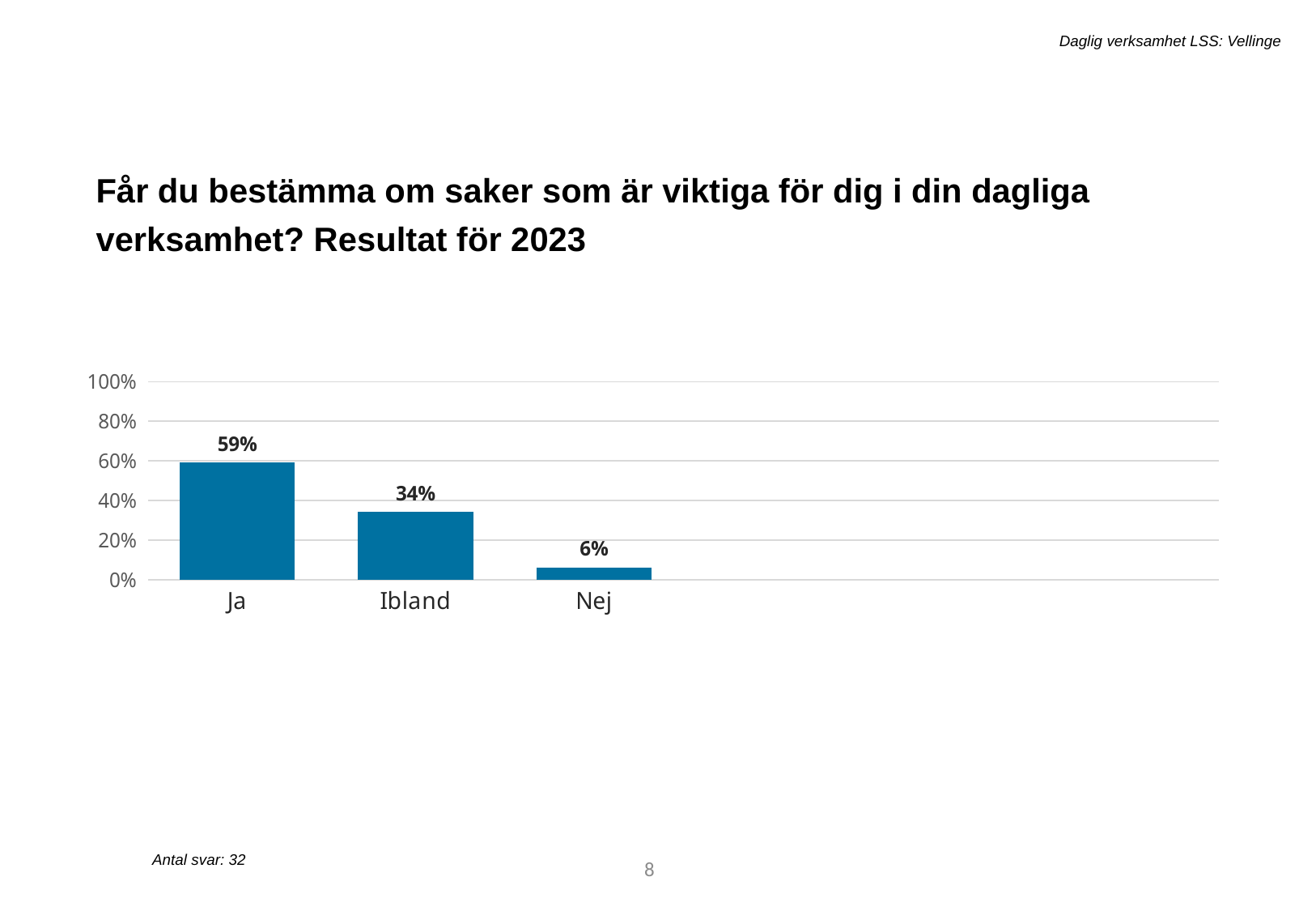
How many categories are shown on the x axis? 3 Which category has the highest value? Ja What kind of chart is shown on the slide? bar chart What is the value for Nej? 6% What is the difference between the values for Ja and Ibland? 25% Which is larger, the value for Ibland or the value for Nej? Ibland Which category has the lowest value? Nej Is the value for Ja greater or less than 40%? greater What is the value for Ibland? 34% What is the value for Ja? 59% What is the difference between the values for Ibland and Nej? 28% Do the values rise or fall from left to right along the x axis? fall